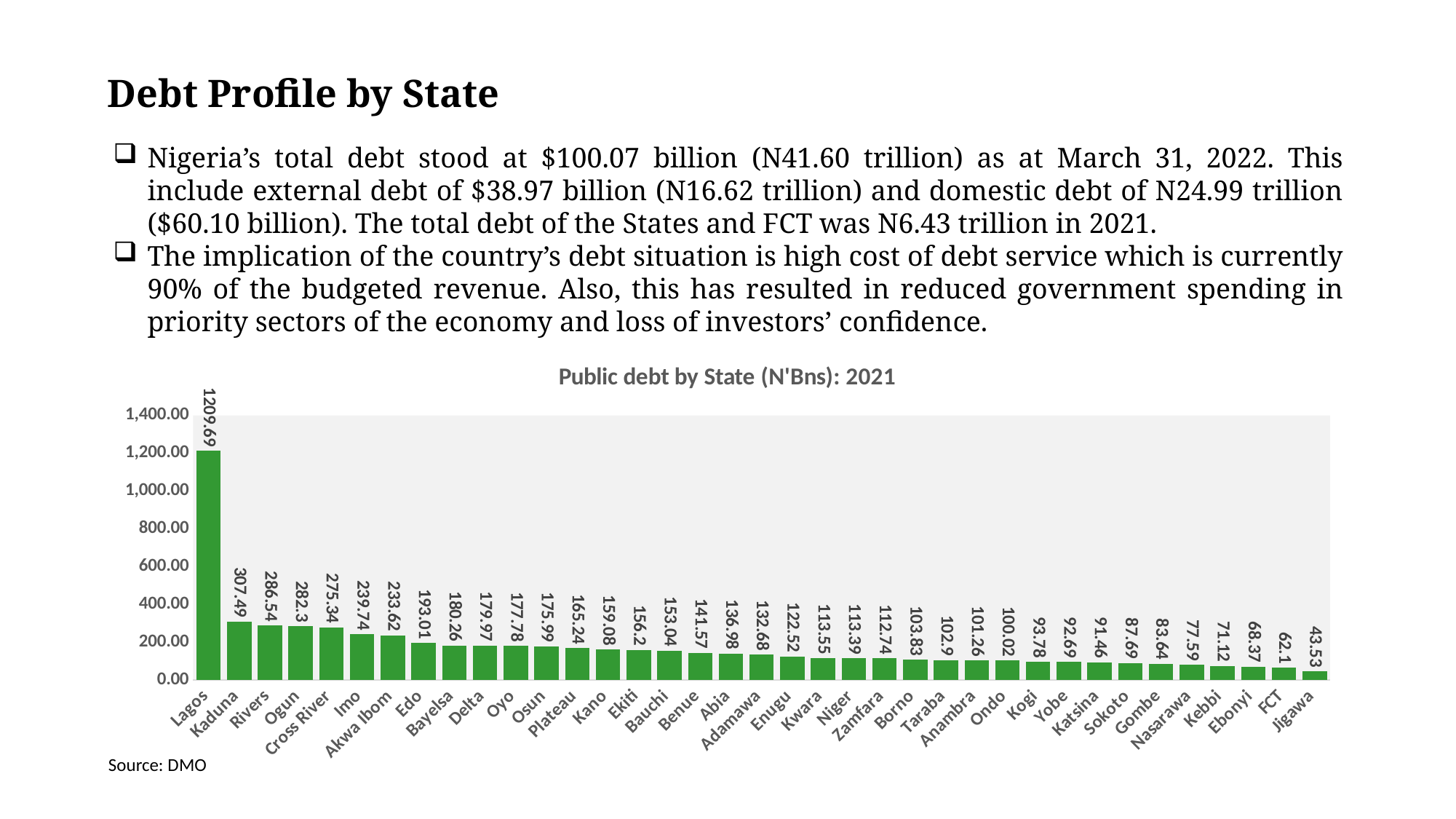
What type of chart is used to show public debt by state? Bar chart What is the public debt value for Kano? 159.08 Do the values rise or fall moving from left to right along the x axis? Fall Which has a larger public debt, Rivers or Imo? Rivers What is the public debt value for FCT? 62.1 What is the public debt value for Lagos? 1209.69 How many states/territories are shown in the chart? 37 Which state has the lowest public debt in the chart? Jigawa What is the difference between the public debt of Lagos and Kaduna? 902.2 Is the value for Kaduna greater or less than 400.00? less Which state has the highest public debt in the chart? Lagos What is the difference between the public debt of Edo and Jigawa? 149.48